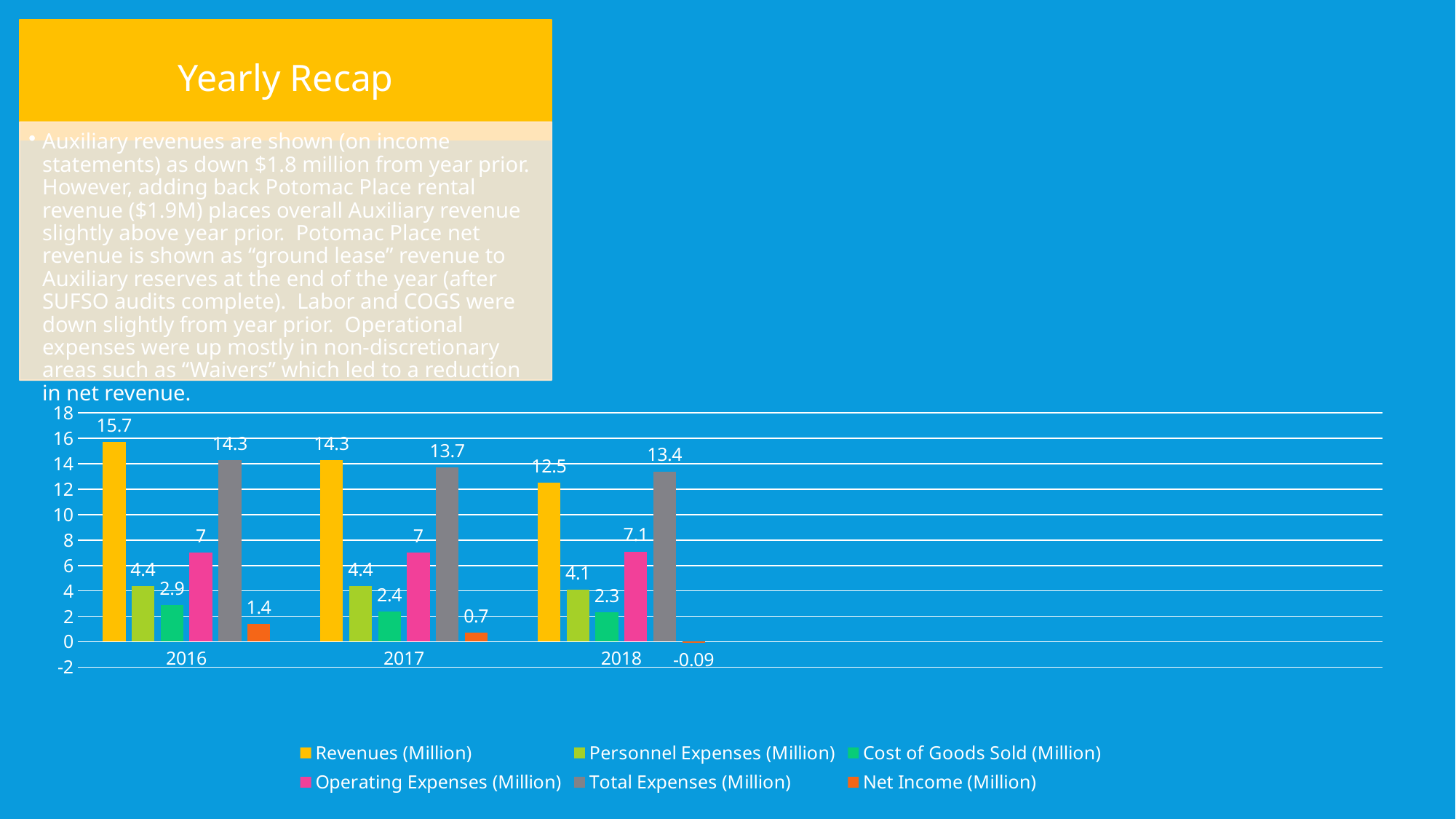
What is the value of Revenues (Million) for 2016? 15.7 Which is larger: Operating Expenses (Million) in 2018 or Personnel Expenses (Million) in 2018? Operating Expenses (Million) in 2018 How many years are shown on the x axis? 3 Which year has the highest Revenues (Million)? 2016 What is the value of Cost of Goods Sold (Million) for 2018? 2.3 What is the value of Net Income (Million) for 2018? -0.09 What is the value of Total Expenses (Million) for 2017? 13.7 How many series does the legend list? 6 What is the difference between Revenues (Million) in 2016 and 2018? 3.2 Which year has the lowest Net Income (Million)? 2018 Do Revenues (Million) rise or fall from 2016 to 2018? Fall What kind of chart is shown on the slide? Bar chart